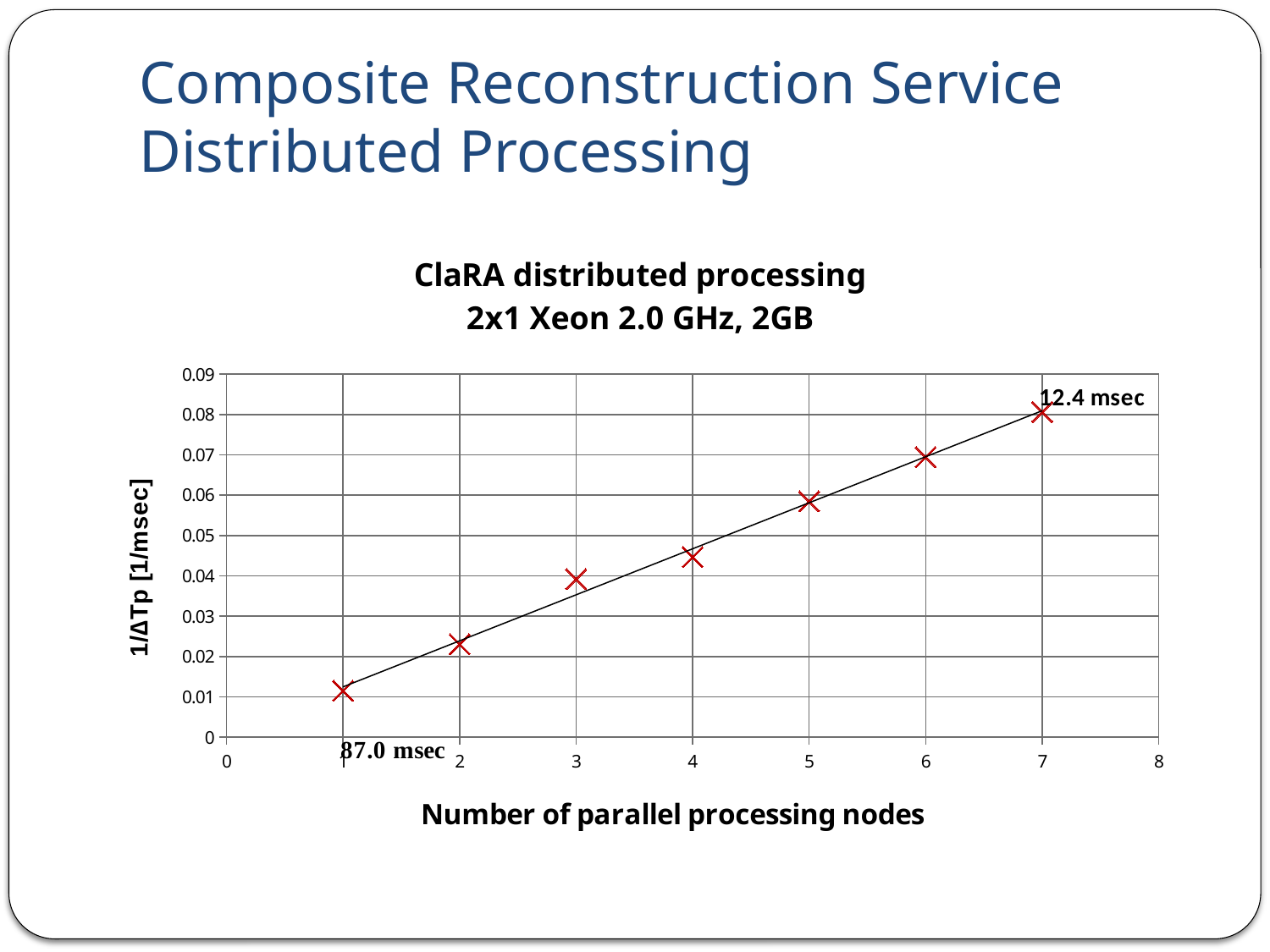
Is the 1/ΔTp value for 5 nodes greater or less than 0.05? greater Do the 1/ΔTp values rise or fall as the number of parallel processing nodes increases? Rise Which number of parallel processing nodes has the lowest 1/ΔTp value? 1 Which number of parallel processing nodes has the highest 1/ΔTp value? 7 What processing time is annotated next to the data point for 7 nodes? 12.4 msec What kind of chart is shown on the slide? Scatter chart How many data points are plotted on the chart? 7 Is the 1/ΔTp value for 7 nodes greater or less than 0.07? greater What is the label of the x axis? Number of parallel processing nodes Is the 1/ΔTp value for 1 node greater or less than 0.02? less Which has a larger 1/ΔTp value: 3 nodes or 5 nodes? 5 nodes What processing time is annotated next to the data point for 1 node? 87.0 msec